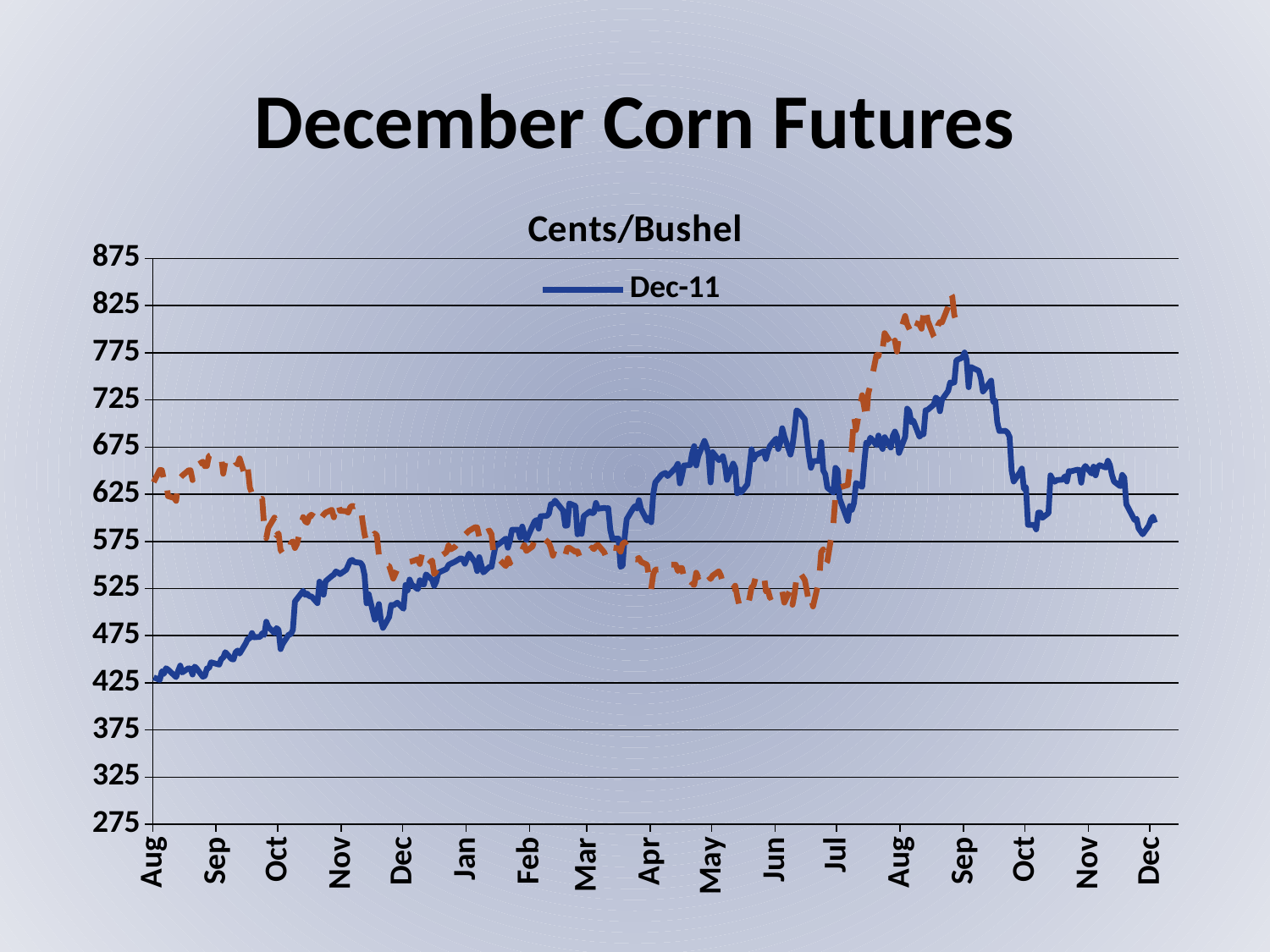
How many series does the chart's legend list? 1 What series name appears in the chart's legend? Dec-11 How many month labels are shown along the x axis? 17 Is the Dec-11 value at the second Sep label larger or smaller than its value at the first Sep label? larger Is the Dec-11 value at the second Sep label greater or less than 725? greater What kind of chart is shown on the slide? line chart Is the Dec-11 value at the Apr label greater or less than 575? greater What is the title shown above the chart's plot area? Cents/Bushel Does the Dec-11 line generally rise or fall from the first Aug label to the second Sep label? rise Is the Dec-11 value at the final Dec label greater or less than 625? less Near which x-axis label does the Dec-11 line reach its highest point? Sep (the second Sep)